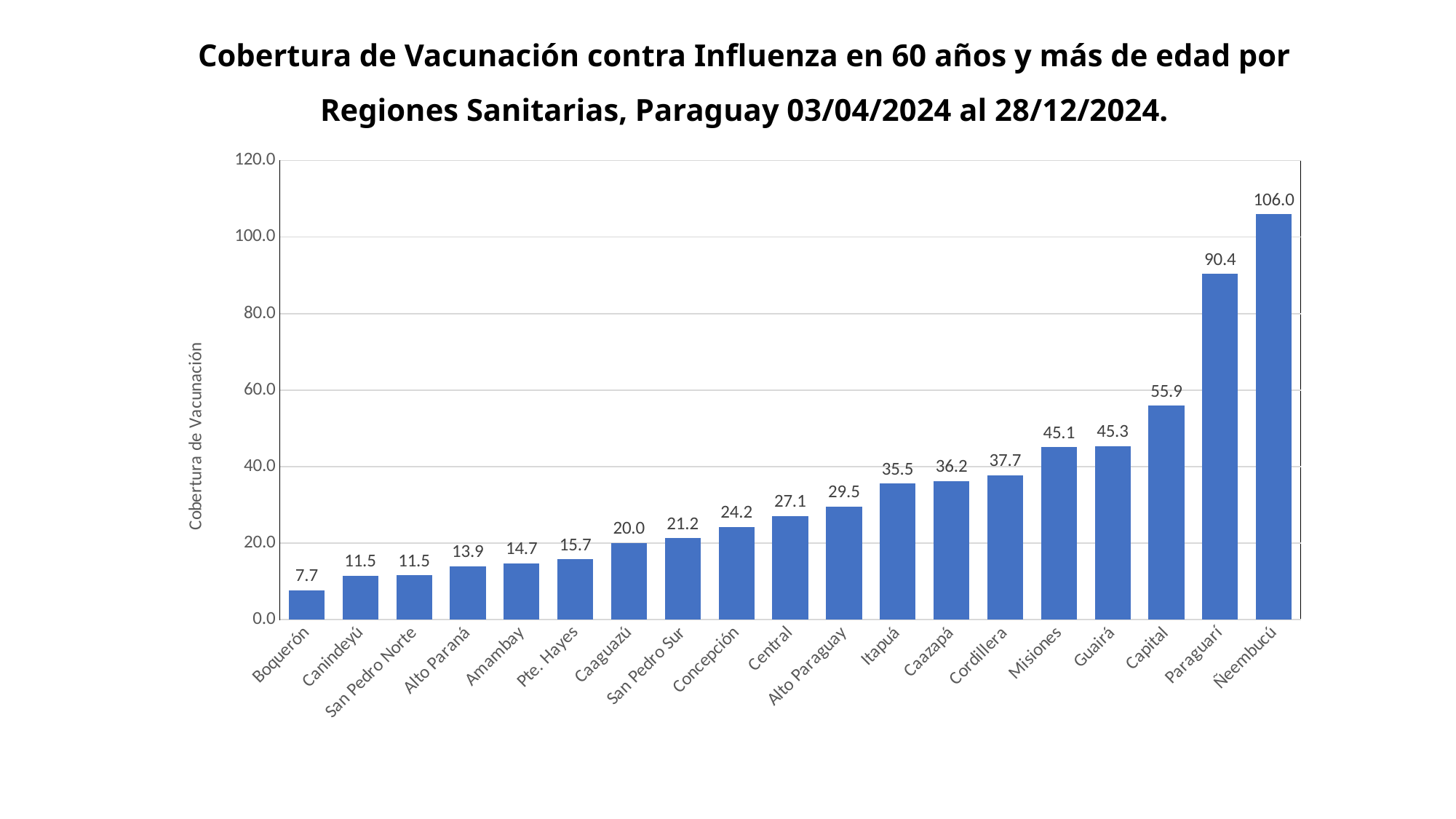
What is the vaccination coverage value for Boquerón? 7.7 Do the values rise or fall from left to right along the x axis? rise How many regions are shown on the x axis? 19 Which region has the highest vaccination coverage? Ñeembucú What is the difference between the values for Ñeembucú and Paraguarí? 15.6 What is the vaccination coverage value for Central? 27.1 Which has a higher value, Itapúa or Cordillera? Cordillera Which region has the lowest vaccination coverage? Boquerón Is the value for Paraguarí greater or less than 80.0? greater What is the vaccination coverage value for Capital? 55.9 What is the label of the vertical axis? Cobertura de Vacunación What kind of chart is shown on the slide? bar chart